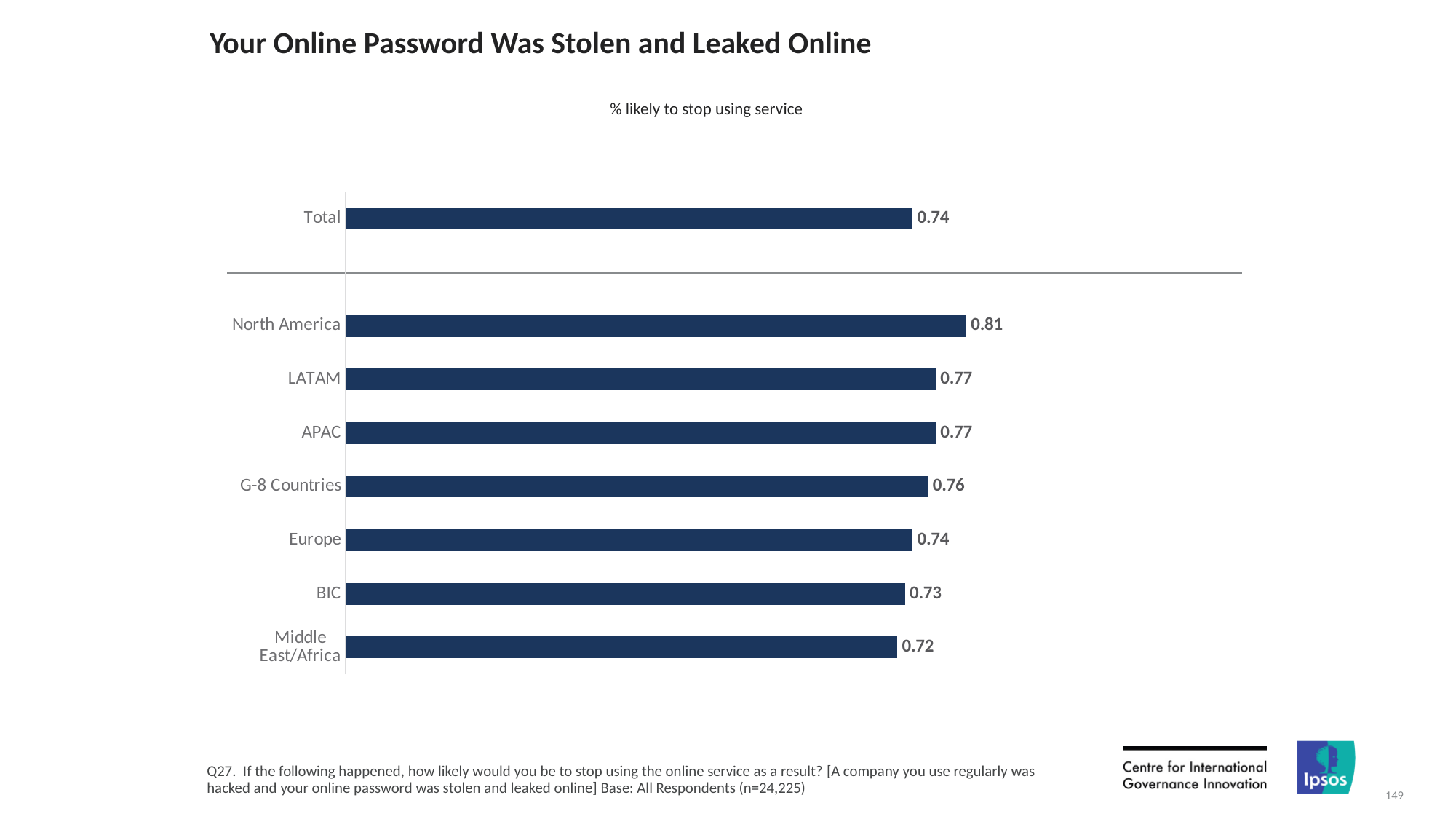
Which region has the lowest value? Middle East/Africa What is the value for the Total bar? 0.74 What is the value for G-8 Countries? 0.76 How many bars are plotted on the chart, including Total? 8 What is the subtitle shown above the chart? % likely to stop using service What kind of chart is shown on the slide? Bar chart What is the difference between the values for North America and Middle East/Africa? 0.09 Which is larger, the value for Europe or the value for G-8 Countries? G-8 Countries What is the value for Middle East/Africa? 0.72 What is the difference between the values for LATAM and BIC? 0.04 Which region has the highest value? North America What is the value for North America? 0.81